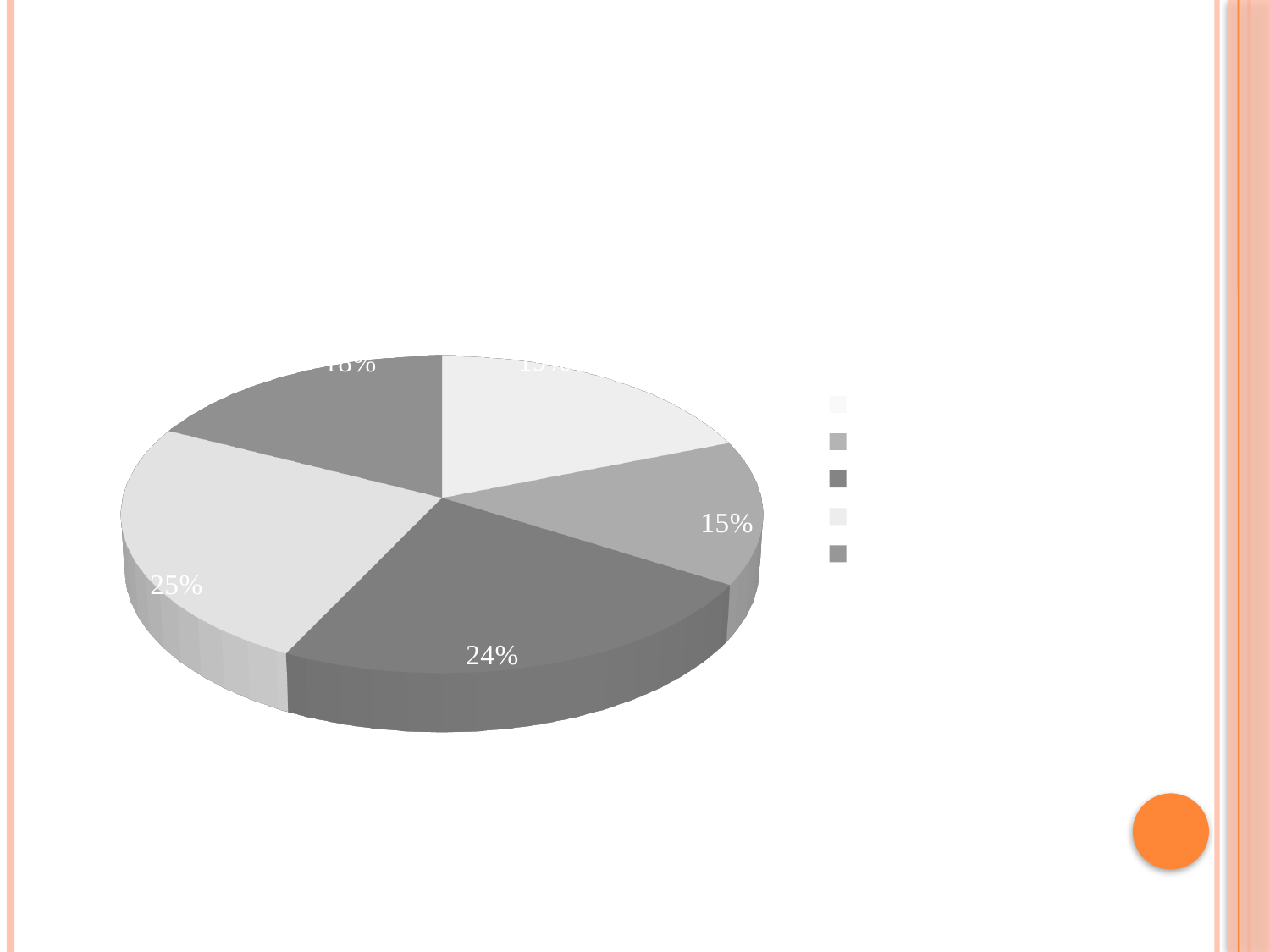
How many slices does the pie chart have? 5 What kind of chart is shown on the slide? pie chart What is the largest percentage labelled on the pie chart? 25% What is the difference between the 25% slice and the 24% slice of the pie chart? 1% What percentage is labelled on the slice at the right of the pie chart? 15% Does the pie chart have a title? No What is the smallest percentage labelled on the pie chart? 15% Which is larger on the pie chart, the slice labelled 24% or the slice labelled 15%? 24% What is the difference between the 24% slice and the 15% slice of the pie chart? 9% What percentage is labelled on the dark grey slice at the bottom of the pie chart? 24% What percentage is labelled on the light slice at the left of the pie chart? 25% How many entries does the legend of the pie chart list? 5